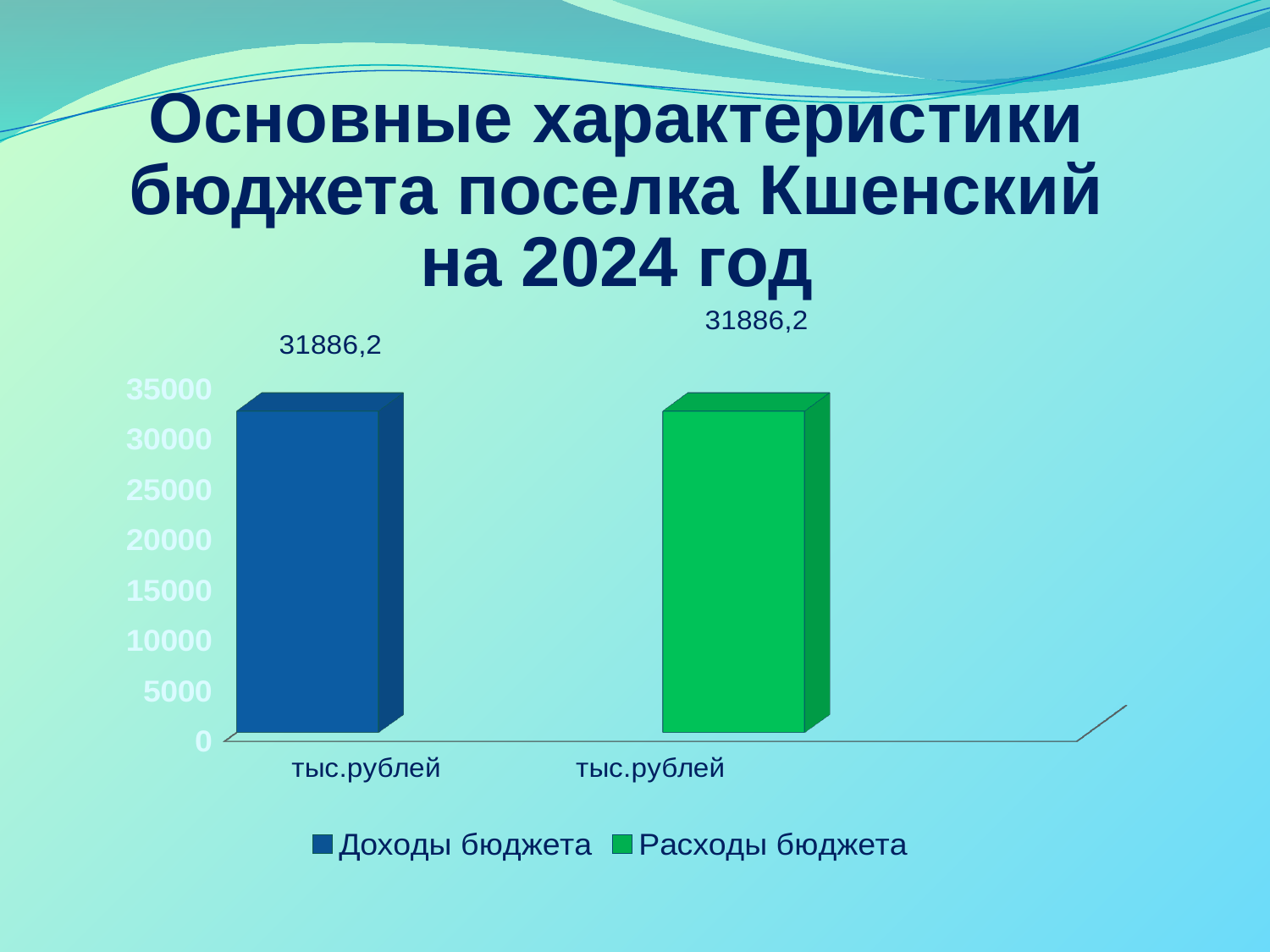
How many bars are plotted on the chart? 2 Which colour represents Расходы бюджета in the legend? green What is the title of the slide? Основные характеристики бюджета поселка Кшенский на 2024 год Is the value for Доходы бюджета greater or less than 30000? greater What is the value of Расходы бюджета? 31886,2 Is the value for Расходы бюджета greater or less than 35000? less How many series does the legend list? 2 What is the value of Доходы бюджета? 31886,2 What is the highest value shown on the vertical axis? 35000 What is the combined total of Доходы бюджета and Расходы бюджета? 63772,4 What kind of chart is shown on the slide? bar chart What is the difference between Доходы бюджета and Расходы бюджета? 0